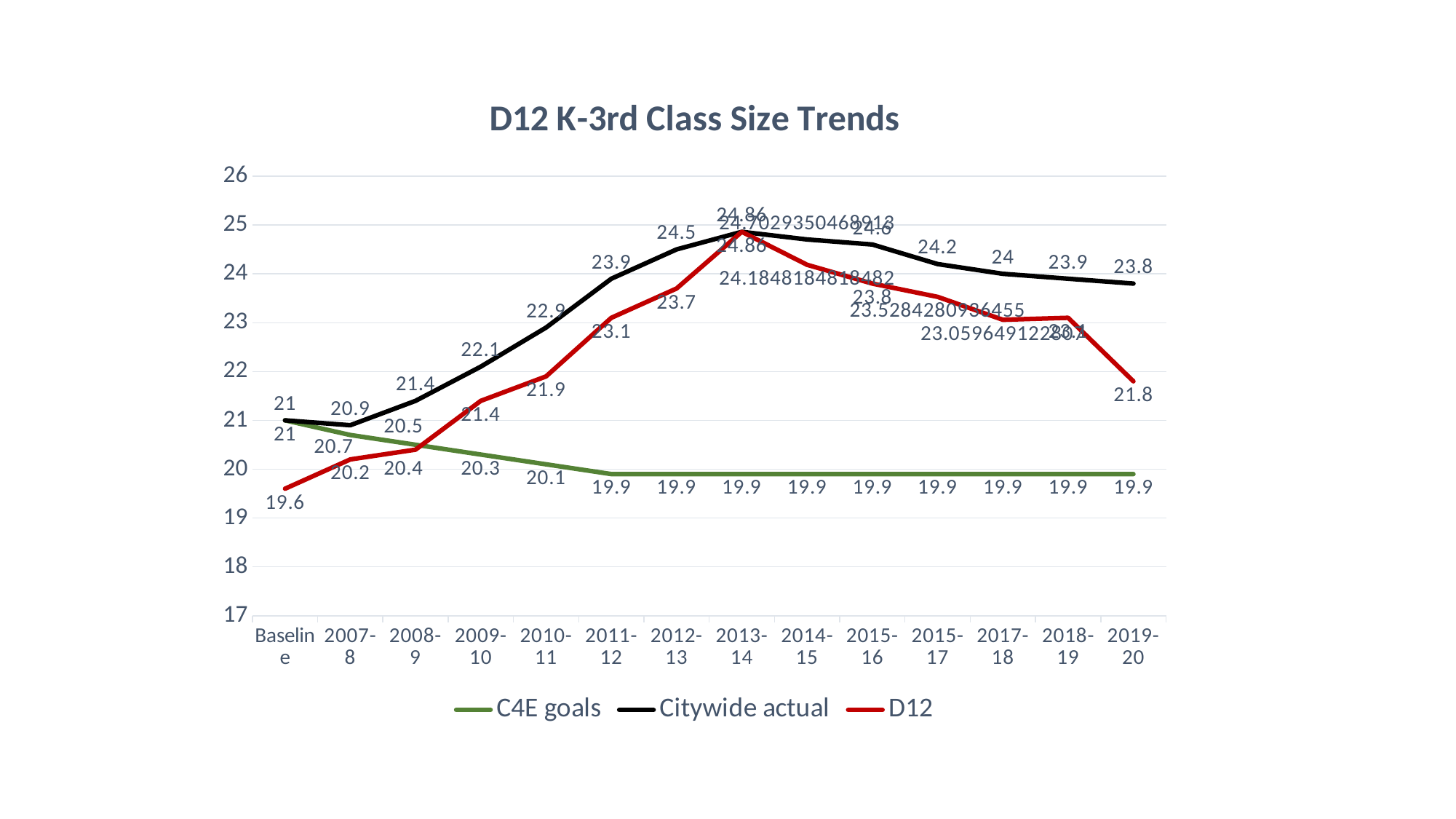
How many series does the legend list? 3 What is the C4E goals value for 2010-11? 20.1 What is the Citywide actual value for 2012-13? 24.5 At which category is the D12 value lowest? Baseline What is the D12 value at Baseline? 19.6 In which year is the Citywide actual value highest? 2013-14 What is the D12 value for 2019-20? 21.8 What is the difference between the Citywide actual and D12 values in 2019-20? 2 Do the C4E goals values rise or fall from Baseline to 2011-12? fall In 2011-12, which is larger: Citywide actual or D12? Citywide actual How many categories are shown along the x axis? 14 What kind of chart is shown on the slide? line chart